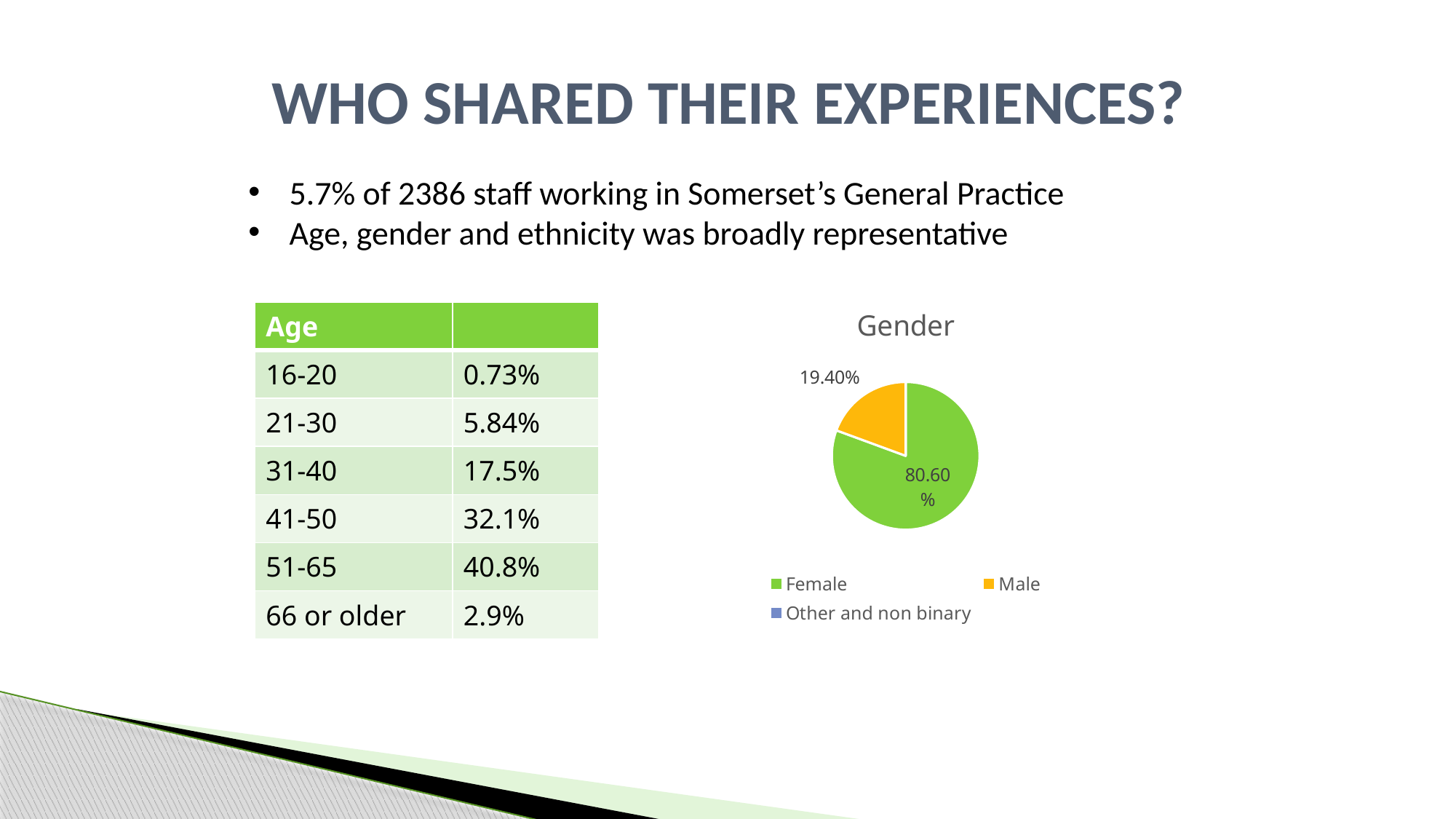
What is the title of the pie chart? Gender What type of chart is shown on the slide? pie chart In the Gender pie chart, what is the share of the pie taken by the Female slice? 80.60% In the Gender pie chart, which of Female or Male has the larger share? Female How many entries does the legend of the Gender pie chart list? 3 In the Gender pie chart, which category has the largest slice? Female In the Gender pie chart, what percentage is shown for Male? 19.40% In the Gender pie chart, what percentage is shown for Female? 80.60% In the Gender pie chart, what colour is the Male slice? orange In the Gender pie chart, what is the difference between the Female and Male percentages? 61.20%